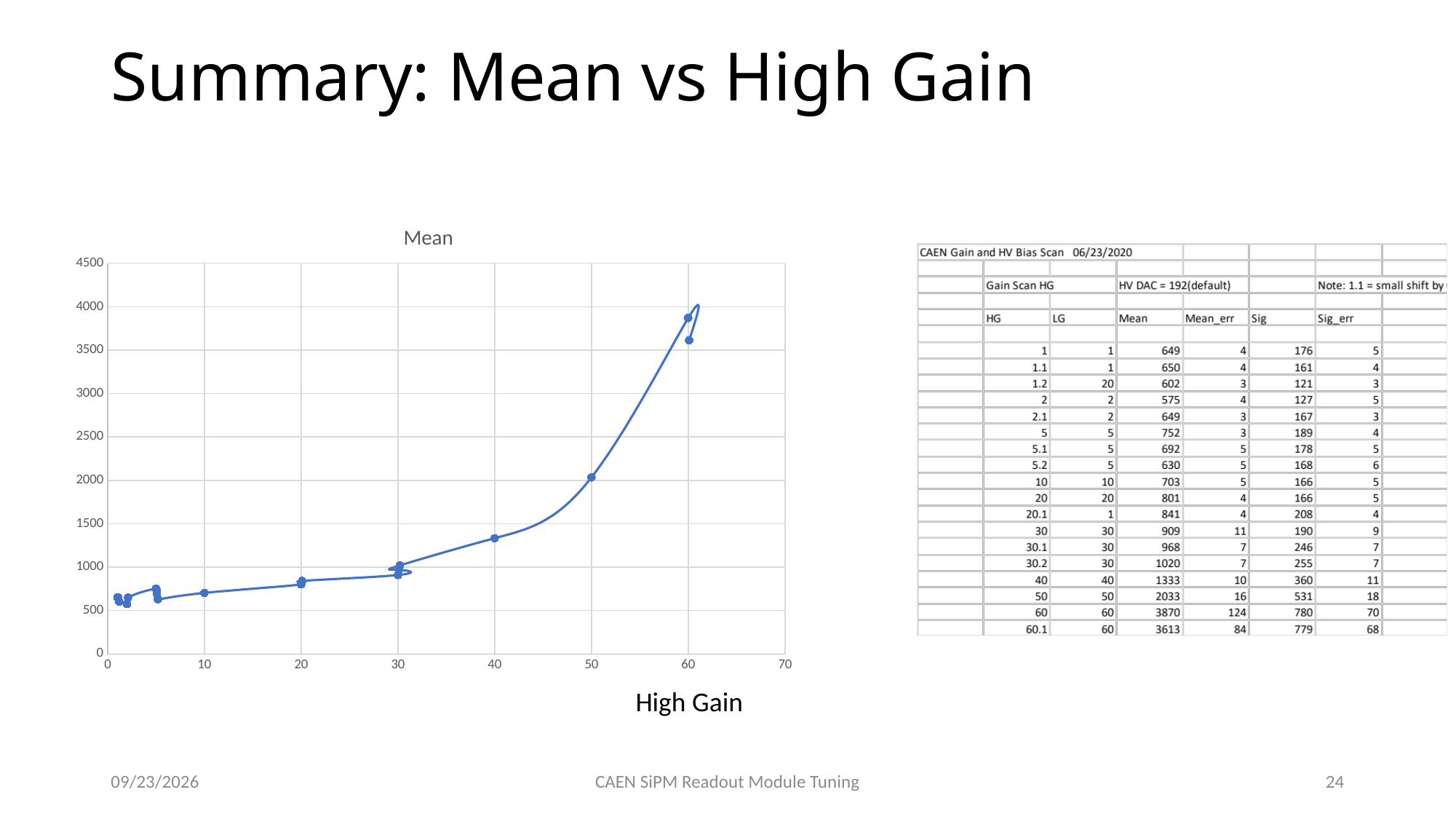
Is the highest Mean value on the chart greater or less than 3500? greater According to the table, what is the Mean at HG 40? 1333 Is the Mean value at High Gain 50 greater or less than 2500? less What is the label of the x axis of the chart? High Gain Is the Mean value at High Gain 10 greater or less than 1000? less What is the title of the chart? Mean Using the table values, what is the difference between the Mean at HG 60 and the Mean at HG 50? 1837 Which is larger, the Mean at High Gain 40 or at High Gain 30? High Gain 40 According to the table, what is the Mean at HG 50? 2033 What kind of chart is shown on the slide? line chart Do the Mean values generally rise or fall as High Gain increases? rise